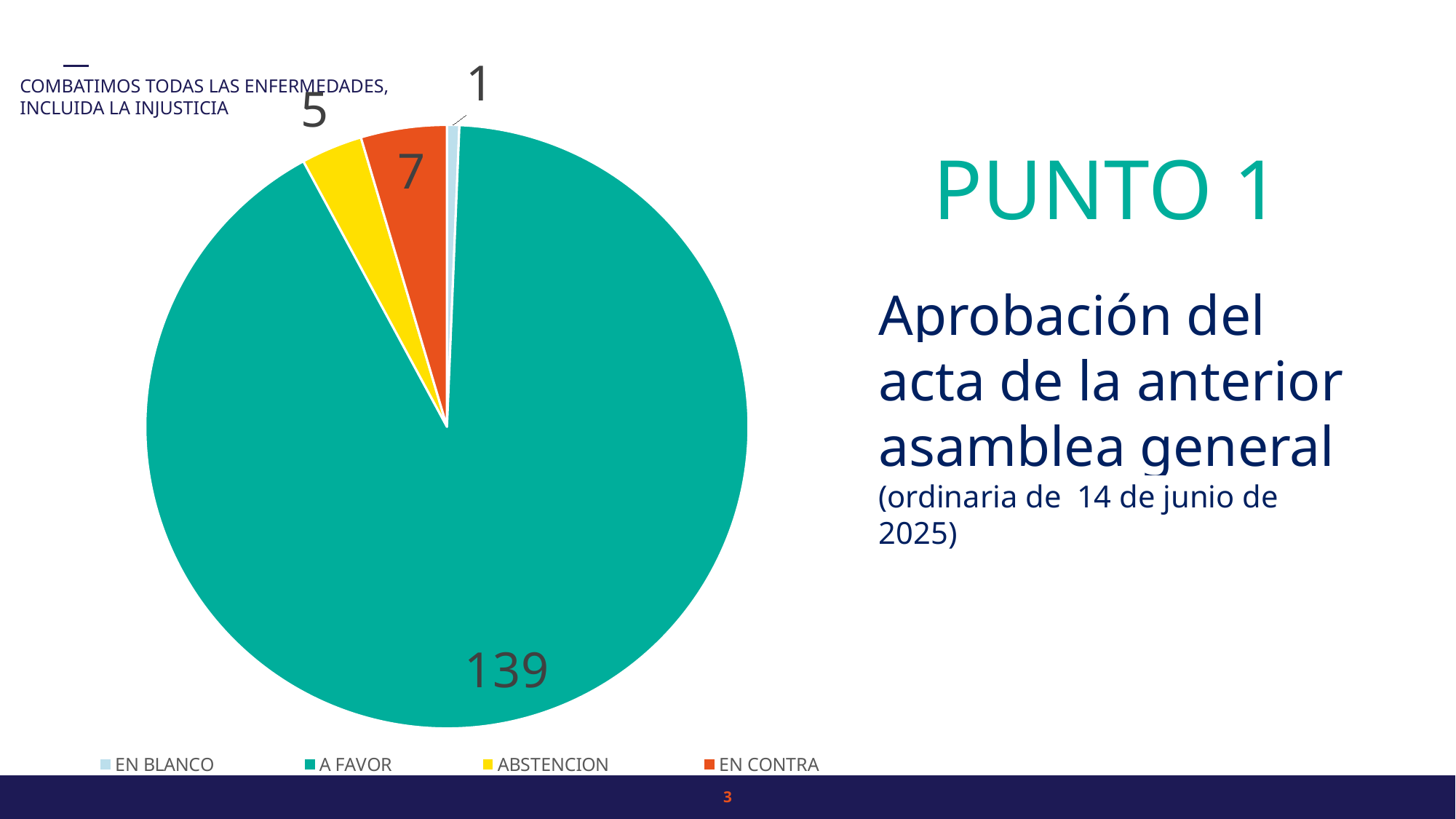
What is the total of all the slices in the pie chart? 152 Which is larger, the value for EN CONTRA or the value for ABSTENCION? EN CONTRA What is the value for ABSTENCION? 5 What is the difference between the values for A FAVOR and EN CONTRA? 132 What is the value for A FAVOR? 139 What kind of chart is shown on the slide? pie chart How many categories does the pie chart have? 4 Which category has the largest slice of the pie? A FAVOR What is the value for EN BLANCO? 1 Which category has the smallest slice of the pie? EN BLANCO Which colour represents ABSTENCION in the legend? yellow What is the value for EN CONTRA? 7